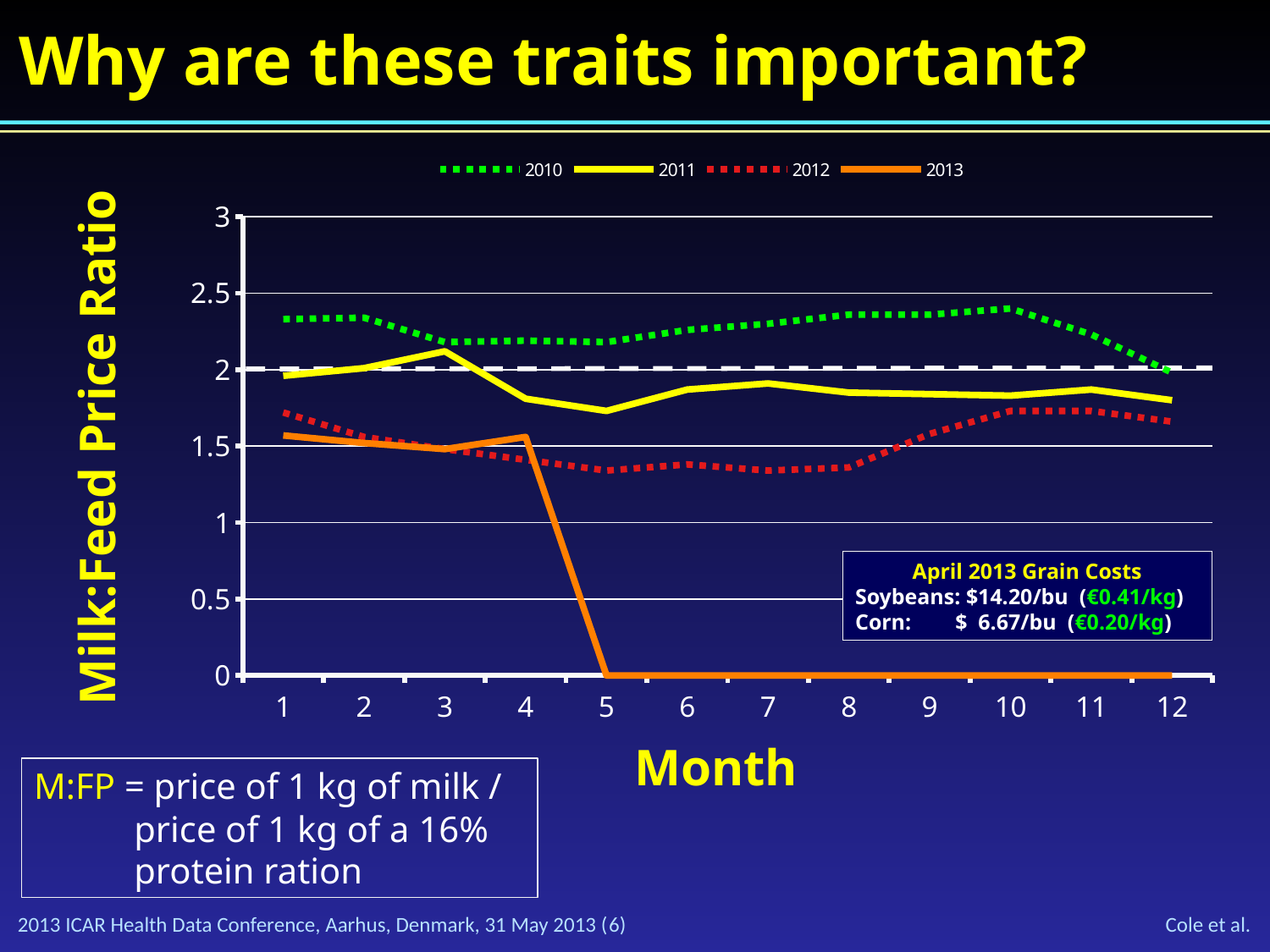
At month 1, which series has the larger value, 2011 or 2012? 2011 Is the 2010 value at month 10 greater or less than 2.5? less What is the title of the y axis? Milk:Feed Price Ratio How many series does the legend list? 4 Which series has the lowest Milk:Feed Price Ratio at month 8? 2013 What kind of chart is shown on the slide? line chart Does the 2013 series rise or fall from month 4 to month 5? fall Is the 2010 value at month 1 greater or less than 2? greater Is the 2012 value at month 7 greater or less than 1.5? less How many months are shown along the x axis? 12 Which series has the highest Milk:Feed Price Ratio at month 6? 2010